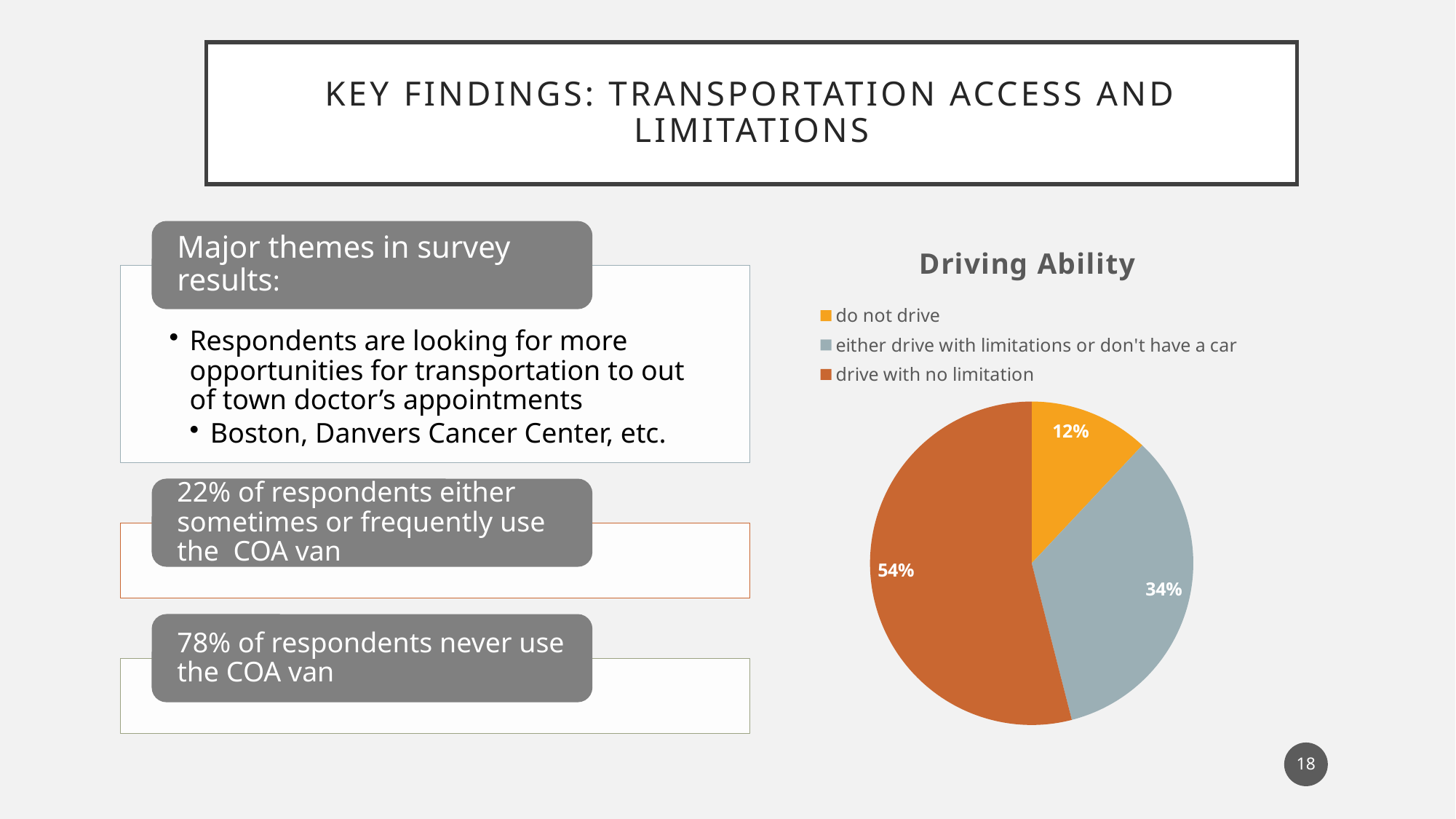
Which category has the largest share of the pie? drive with no limitation What percentage of respondents drive with no limitation? 54% What colour is the 'do not drive' slice? orange/yellow What percentage of respondents either drive with limitations or don't have a car? 34% What is the title of the chart? Driving Ability What is the difference in percentage points between 'drive with no limitation' and 'do not drive'? 42 What is the combined share of respondents who do not drive or drive with limitations or don't have a car? 46% Which category has the smallest share of the pie? do not drive How many categories does the pie chart show? 3 What percentage of respondents do not drive? 12% Which is larger: the share for 'either drive with limitations or don't have a car' or the share for 'do not drive'? either drive with limitations or don't have a car What kind of chart is shown on the slide? pie chart